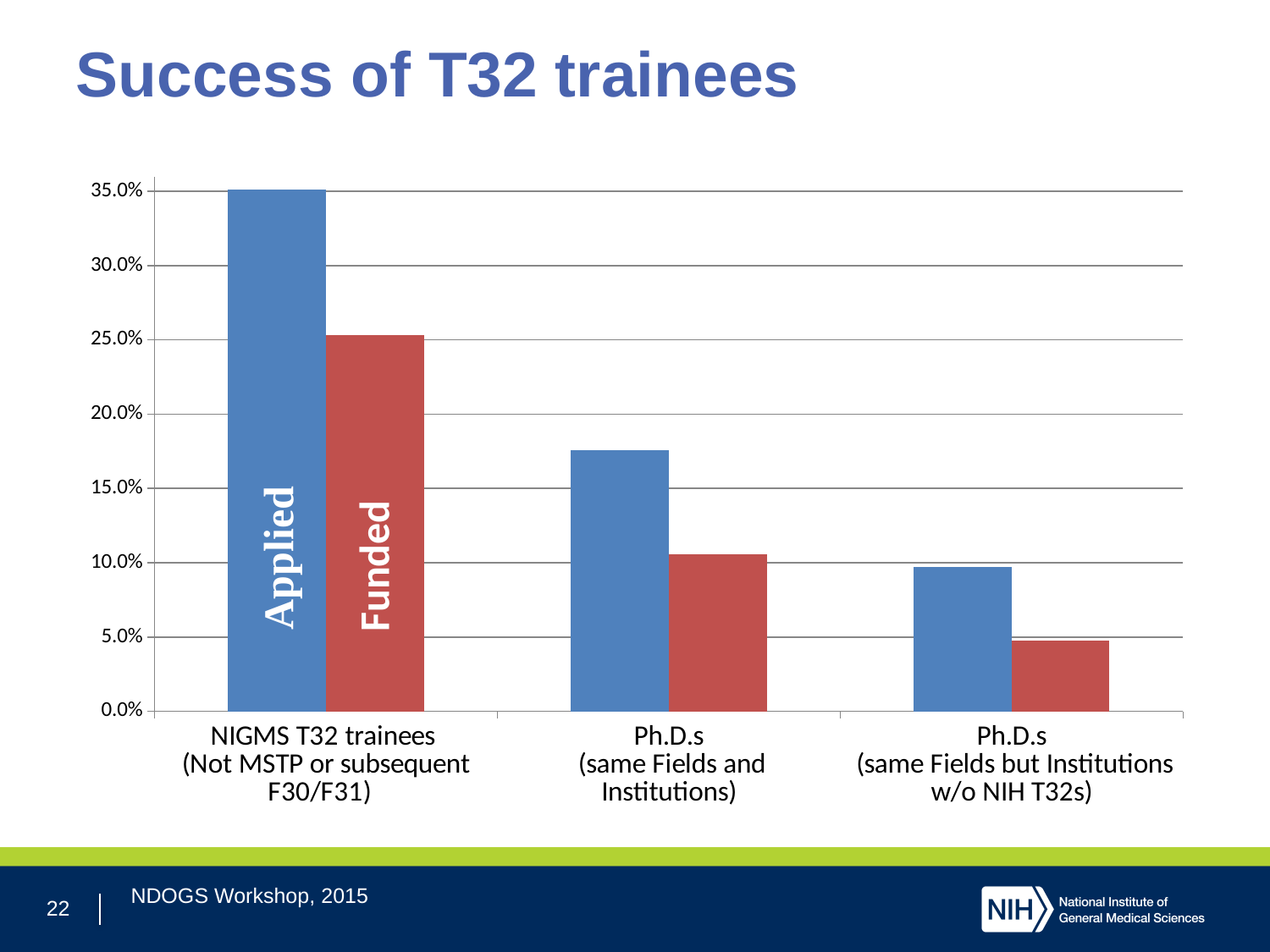
What is the title of the slide's chart? Success of T32 trainees Is the Funded value for Ph.D.s (same Fields but Institutions w/o NIH T32s) greater or less than 10.0%? less Do the Applied values rise or fall from left to right across the categories? fall What kind of chart is shown on the slide? bar chart Which category has the lowest Funded value? Ph.D.s (same Fields but Institutions w/o NIH T32s) Which is larger: the Applied value for Ph.D.s (same Fields and Institutions) or the Applied value for Ph.D.s (same Fields but Institutions w/o NIH T32s)? Ph.D.s (same Fields and Institutions) Is the Applied value for Ph.D.s (same Fields and Institutions) greater or less than 20.0%? less Is the Funded value for NIGMS T32 trainees greater or less than 20.0%? greater How many categories are shown on the x axis of the chart? 3 How many series are plotted in the chart? 2 Which category has the highest Applied value? NIGMS T32 trainees (Not MSTP or subsequent F30/F31)